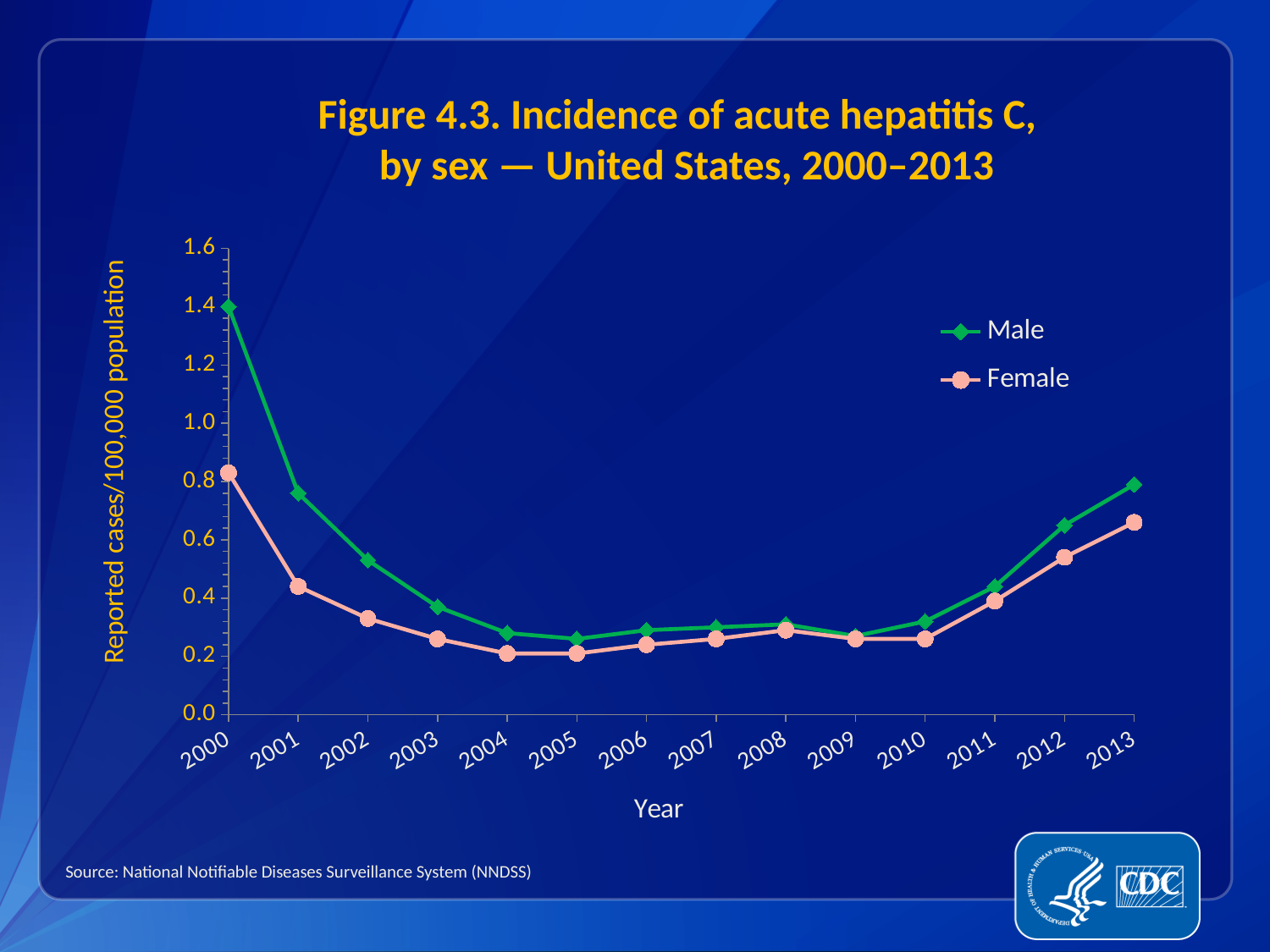
Do the Female values rise or fall from 2010 to 2013? Rise Do the Male values rise or fall from 2000 to 2005? Fall What kind of chart is shown on the slide? Line chart How many series does the legend list? 2 Is the Male value for 2004 greater or less than 0.4? less Is the Female value for 2013 greater or less than 0.8? less How many years are plotted along the x axis? 14 In which year is the Female incidence rate highest? 2000 Is the Female value for 2000 greater or less than 0.6? greater In 2013, which series has the larger value, Male or Female? Male In which year is the Male incidence rate highest? 2000